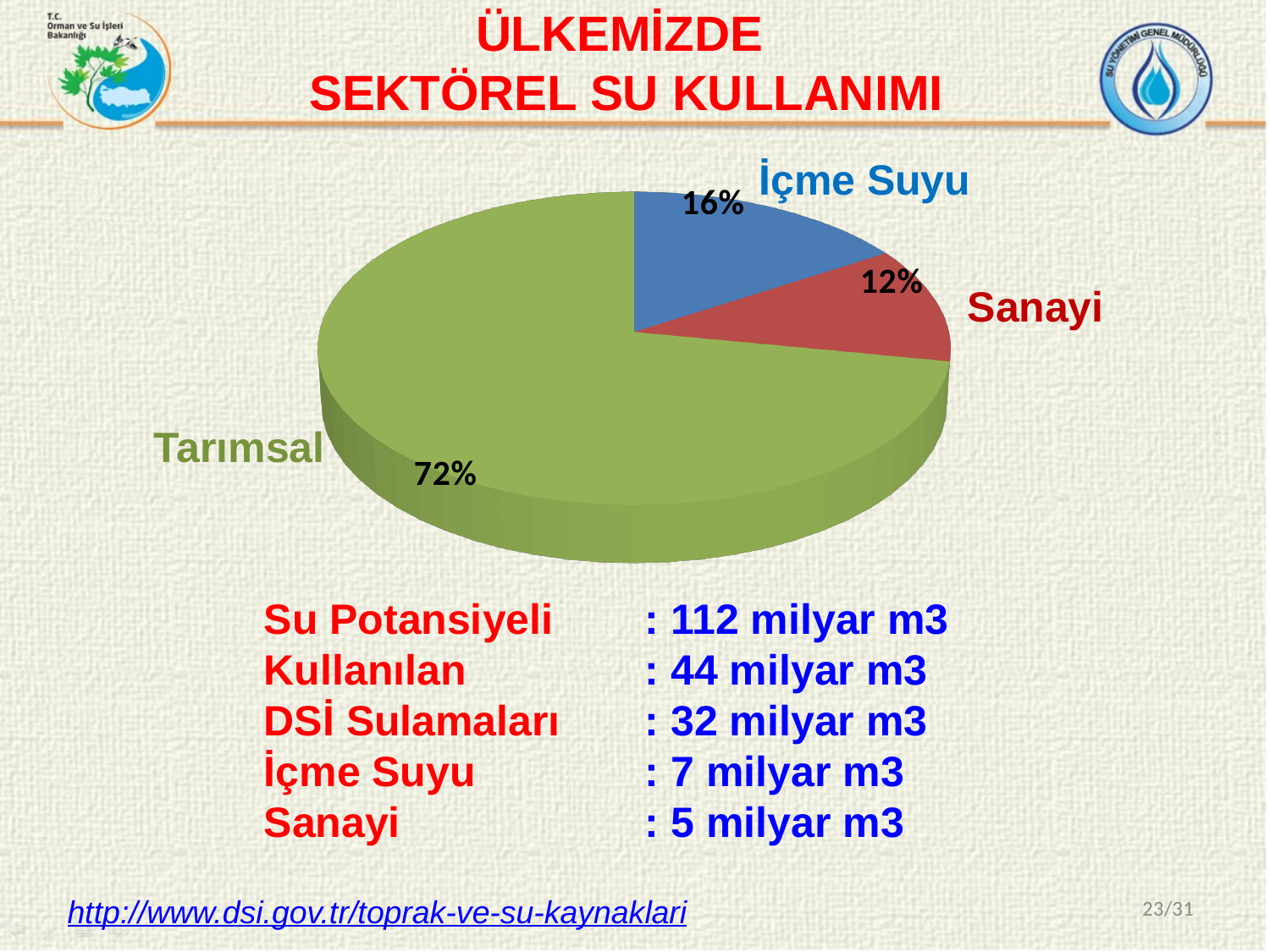
How many slices does the pie chart have? 3 What share of the pie does Tarımsal have? 72% Which is larger, the share for İçme Suyu or the share for Sanayi? İçme Suyu Which category has the smallest slice of the pie? Sanayi What kind of chart is shown on the slide? pie chart What colour is the Tarımsal slice of the pie? green What share of the pie does Sanayi have? 12% What is the title of the slide containing the pie chart? ÜLKEMİZDE SEKTÖREL SU KULLANIMI Which category has the largest slice of the pie? Tarımsal What is the difference in percentage points between Tarımsal and İçme Suyu? 56% What share of the pie does İçme Suyu have? 16% What is the difference in percentage points between İçme Suyu and Sanayi? 4%